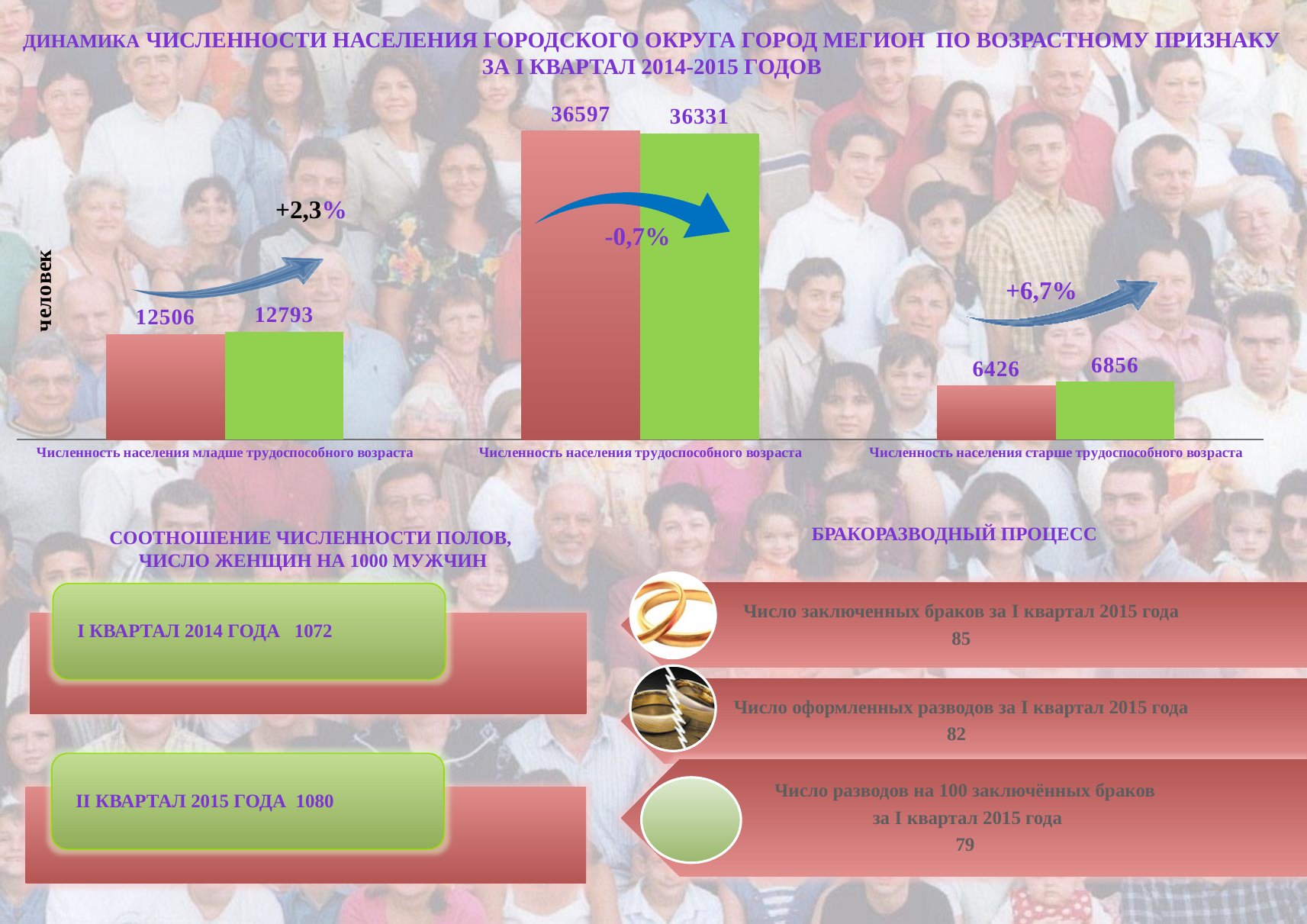
Which category has the lowest values in the bar chart? Численность населения старше трудоспособного возраста What is the value of the green bar for 'Численность населения старше трудоспособного возраста'? 6856 How many categories are shown on the x axis of the bar chart? 3 For 'Численность населения младше трудоспособного возраста', which bar is larger, the red one or the green one? the green one What is the value of the red bar for 'Численность населения младше трудоспособного возраста'? 12506 What is the difference between the green bar and the red bar for 'Численность населения старше трудоспособного возраста'? 430 What is the difference between the red bar and the green bar for 'Численность населения трудоспособного возраста'? 266 What percentage change is shown above the bars for 'Численность населения старше трудоспособного возраста'? +6,7% What is the value of the green bar for 'Численность населения младше трудоспособного возраста'? 12793 What is the value of the red bar for 'Численность населения трудоспособного возраста'? 36597 Which category has the highest values in the bar chart? Численность населения трудоспособного возраста What type of chart is shown at the top of the slide? bar chart